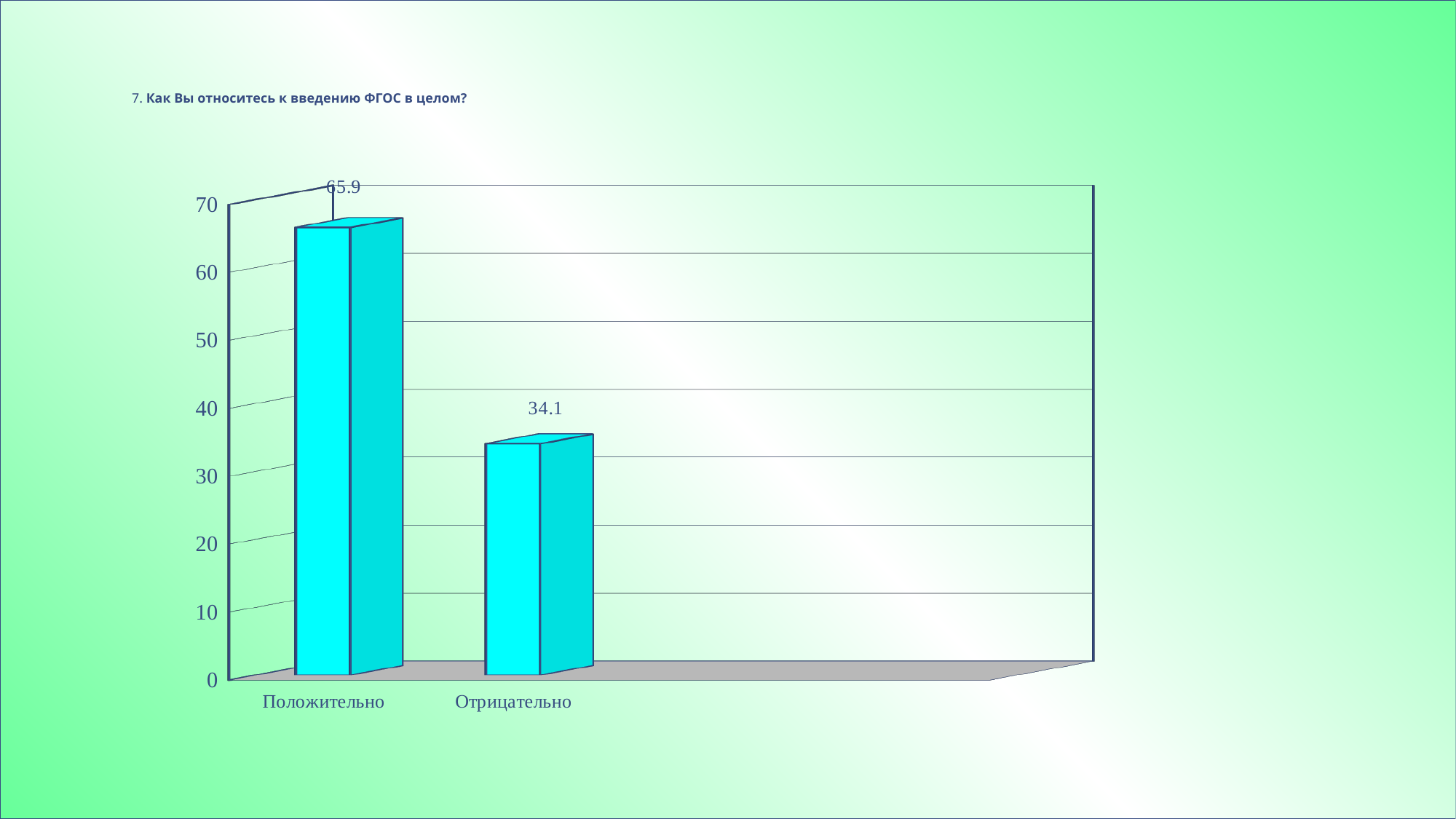
What is the difference between the values for Положительно and Отрицательно? 31.8 Which is larger, the value for Положительно or the value for Отрицательно? Положительно Which category has the highest value? Положительно What kind of chart is shown on the slide? bar chart What is the total of the two values shown on the chart? 100 What is the value for Отрицательно? 34.1 What is the value for Положительно? 65.9 Is the value for Отрицательно greater or less than 40? less How many categories are shown on the chart? 2 What is the highest value shown on the vertical axis? 70 Which category has the lowest value? Отрицательно Is the value for Положительно greater or less than 60? greater